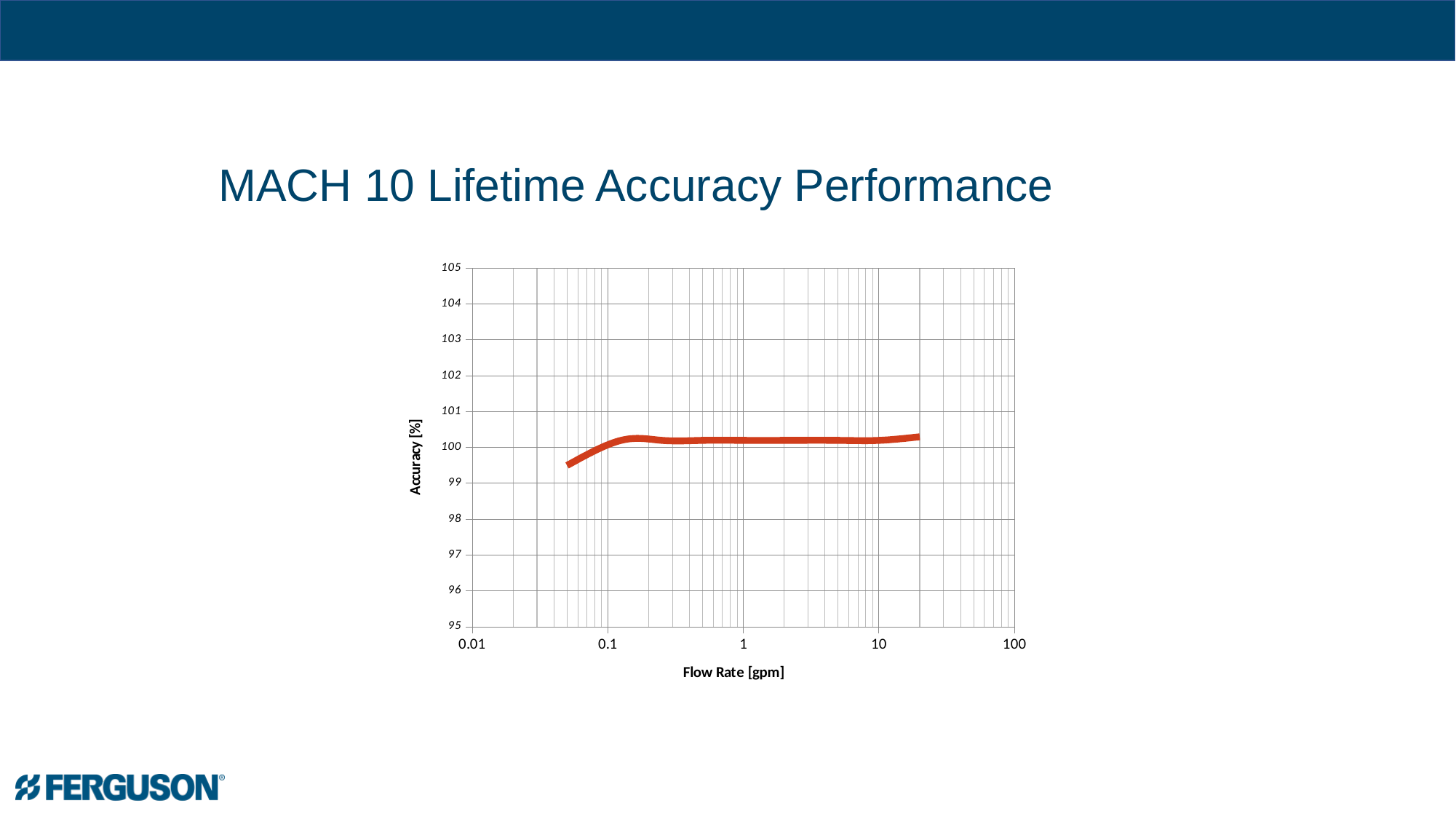
What is the title of the chart on the slide? MACH 10 Lifetime Accuracy Performance What is the label of the y axis? Accuracy [%] Is the accuracy at a flow rate of 0.05 gpm greater or less than 100? less At which end of the plotted line is the accuracy lowest, the lowest flow rate or the highest flow rate? the lowest flow rate Is the accuracy at a flow rate of 0.05 gpm greater or less than 99? greater Is the accuracy at a flow rate of 1 gpm greater or less than 99? greater How many lines (data series) are plotted on the chart? 1 Which flow rate has the lower accuracy, 0.05 gpm or 1 gpm? 0.05 gpm What kind of chart is shown on the slide? line chart Does the accuracy rise or fall as the flow rate increases from 0.05 gpm to 0.1 gpm? rise